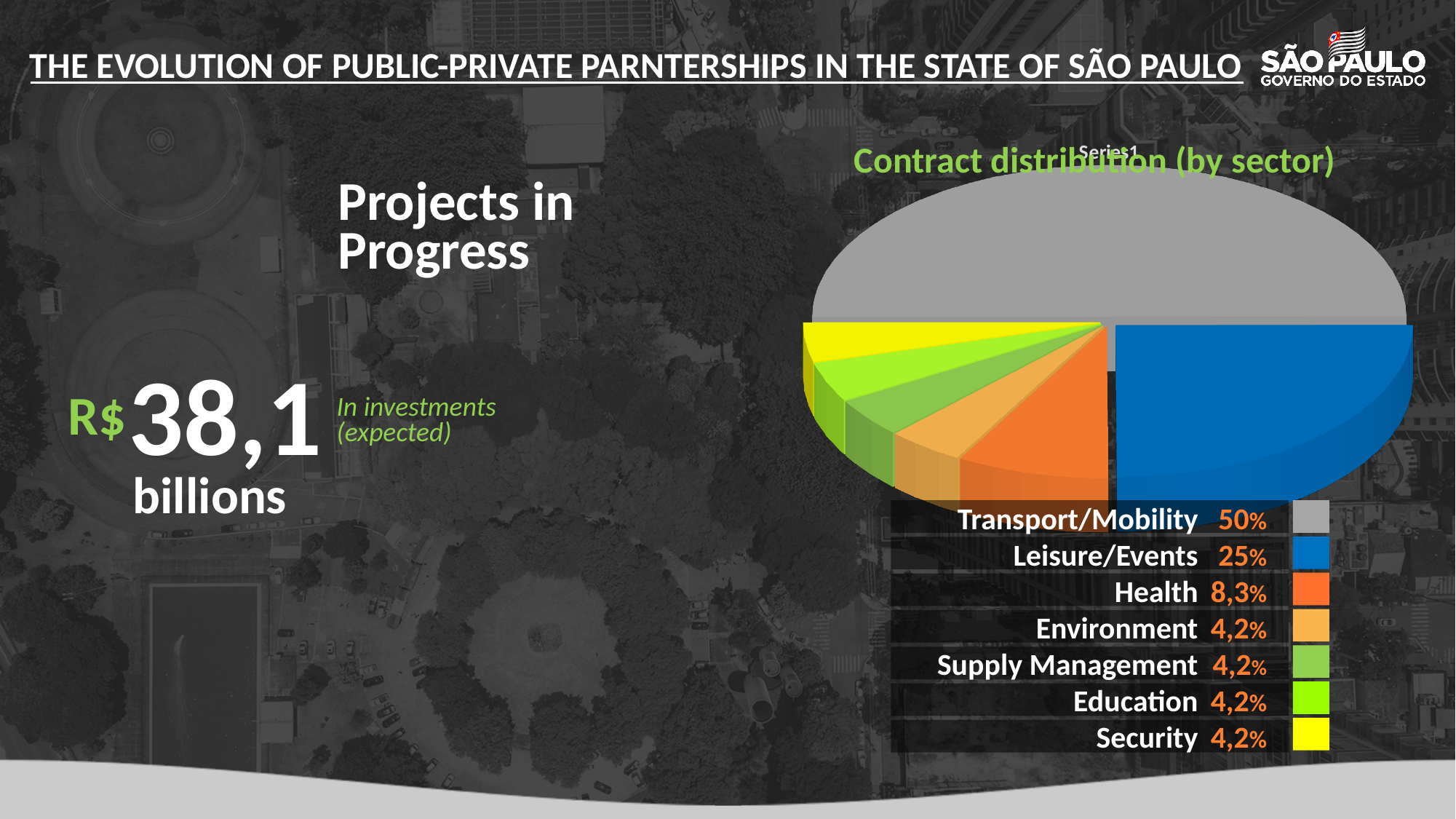
What share of contracts does Transport/Mobility hold in the Contract distribution (by sector) chart? 50% What share of contracts does Leisure/Events hold in the Contract distribution (by sector) chart? 25% What colour represents Leisure/Events in the Contract distribution (by sector) chart? Blue How many sectors in the Contract distribution (by sector) chart have a share of 4,2%? 4 What is the title of the pie chart on the slide? Contract distribution (by sector) Which sector has the largest share in the Contract distribution (by sector) chart? Transport/Mobility What share of contracts does Security hold in the Contract distribution (by sector) chart? 4,2% What share of contracts does Health hold in the Contract distribution (by sector) chart? 8,3% What kind of chart is the Contract distribution (by sector) chart? Pie chart Which has a larger share in the Contract distribution (by sector) chart, Health or Environment? Health What is the difference in share between Transport/Mobility and Leisure/Events in the Contract distribution (by sector) chart? 25% How many sectors are listed in the Contract distribution (by sector) chart? 7